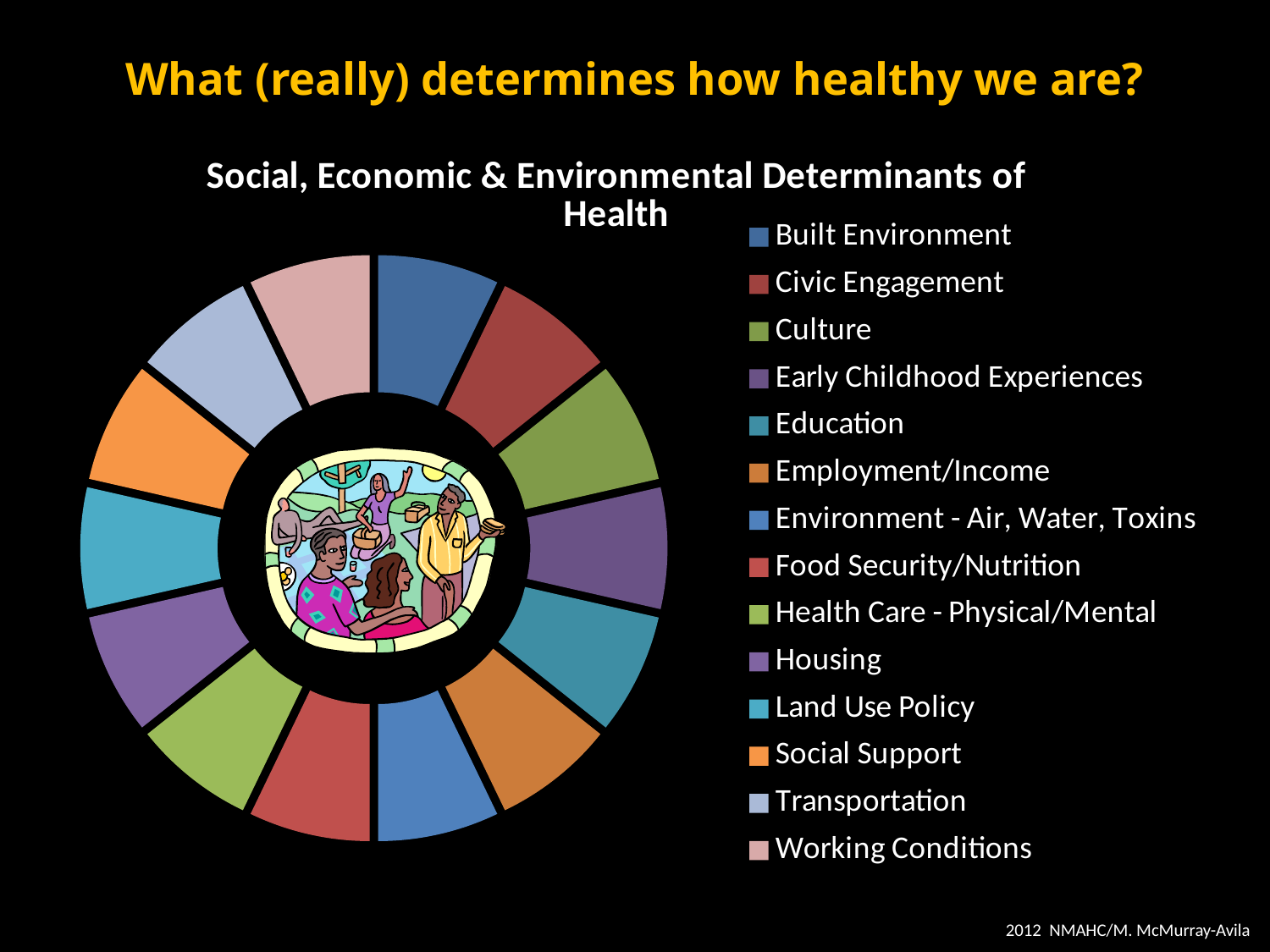
Are the slices of the chart roughly equal in size, or does one slice clearly dominate? roughly equal How many categories (slices) does the chart have? 14 Which legend entry is listed first in the chart's legend? Built Environment What is the title of the chart? Social, Economic & Environmental Determinants of Health What kind of chart is shown on the slide? doughnut chart How many entries does the chart's legend list? 14